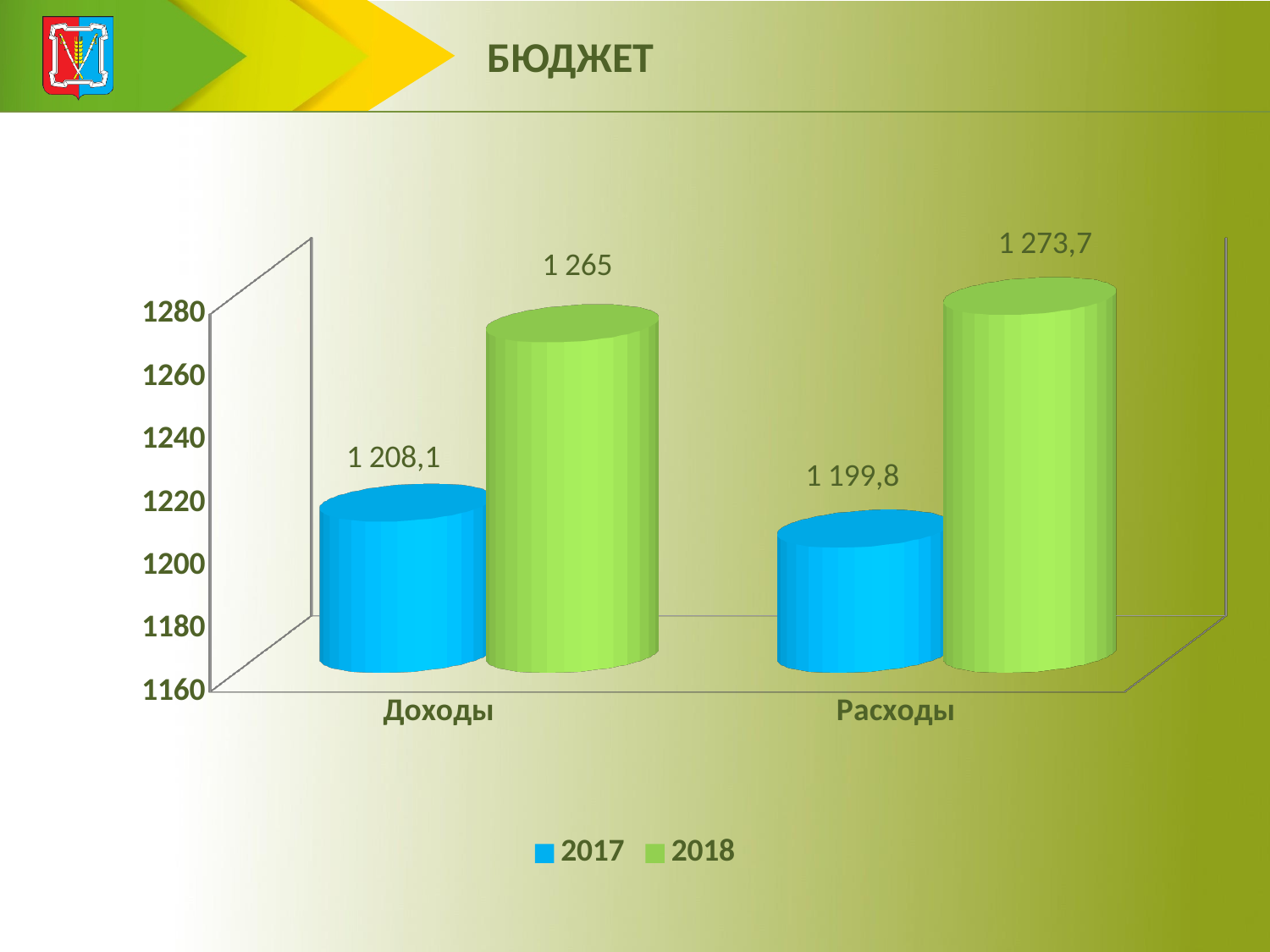
What kind of chart is shown on the slide? Bar chart What is the value for Расходы in 2018? 1 273,7 What is the difference between the 2018 and 2017 values for Доходы? 56,9 Which bar has the lowest value on the chart? Расходы 2017 Which is larger in 2018: Доходы or Расходы? Расходы What is the difference between the 2018 and 2017 values for Расходы? 73,9 What is the value for Доходы in 2017? 1 208,1 What is the value for Расходы in 2017? 1 199,8 What is the value for Доходы in 2018? 1 265 Which bar has the highest value on the chart? Расходы 2018 How many series does the legend list? 2 What is the title of the slide? БЮДЖЕТ